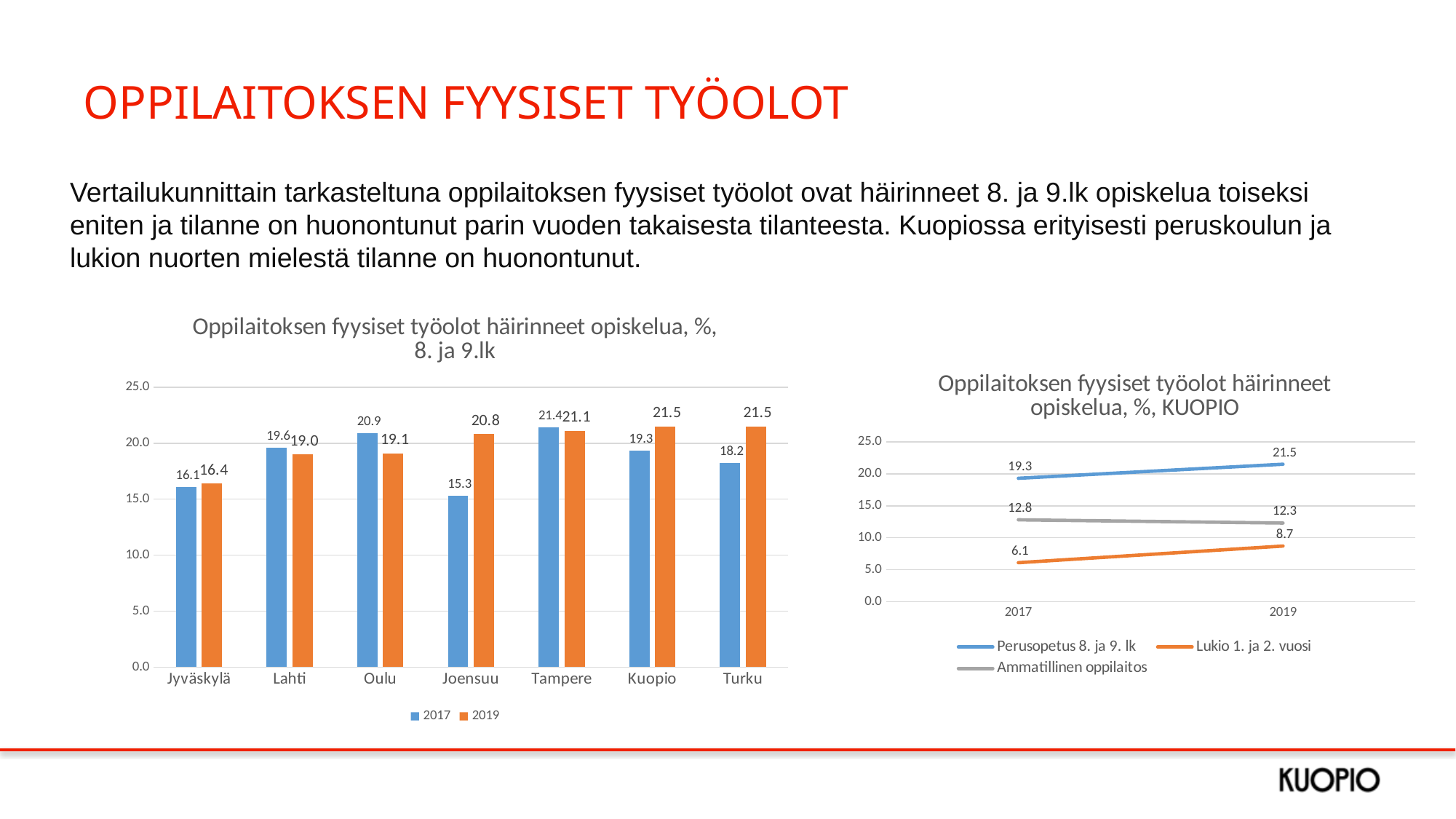
In the left bar chart, which city has the lowest 2017 value? Joensuu In the left bar chart, is the 2019 value for Oulu larger or smaller than its 2017 value? smaller In the right chart for Kuopio, how many series does the legend list? 3 In the right chart titled 'Oppilaitoksen fyysiset työolot häirinneet opiskelua, %, KUOPIO', what is the 2019 value for Lukio 1. ja 2. vuosi? 8.7 How many cities are shown in the left bar chart? 7 In the left bar chart, what is the difference between the 2019 and 2017 values for Joensuu? 5.5 In the left bar chart, what is the 2019 value for Joensuu? 20.8 In the right chart for Kuopio, what is the difference between the 2019 and 2017 values for Perusopetus 8. ja 9. lk? 2.2 In the right chart for Kuopio, does the Ammatillinen oppilaitos line rise or fall from 2017 to 2019? fall In the left bar chart, what is the 2017 value for Turku? 18.2 What type of chart is the chart on the left? bar chart In the left bar chart, which city has the highest 2017 value? Tampere